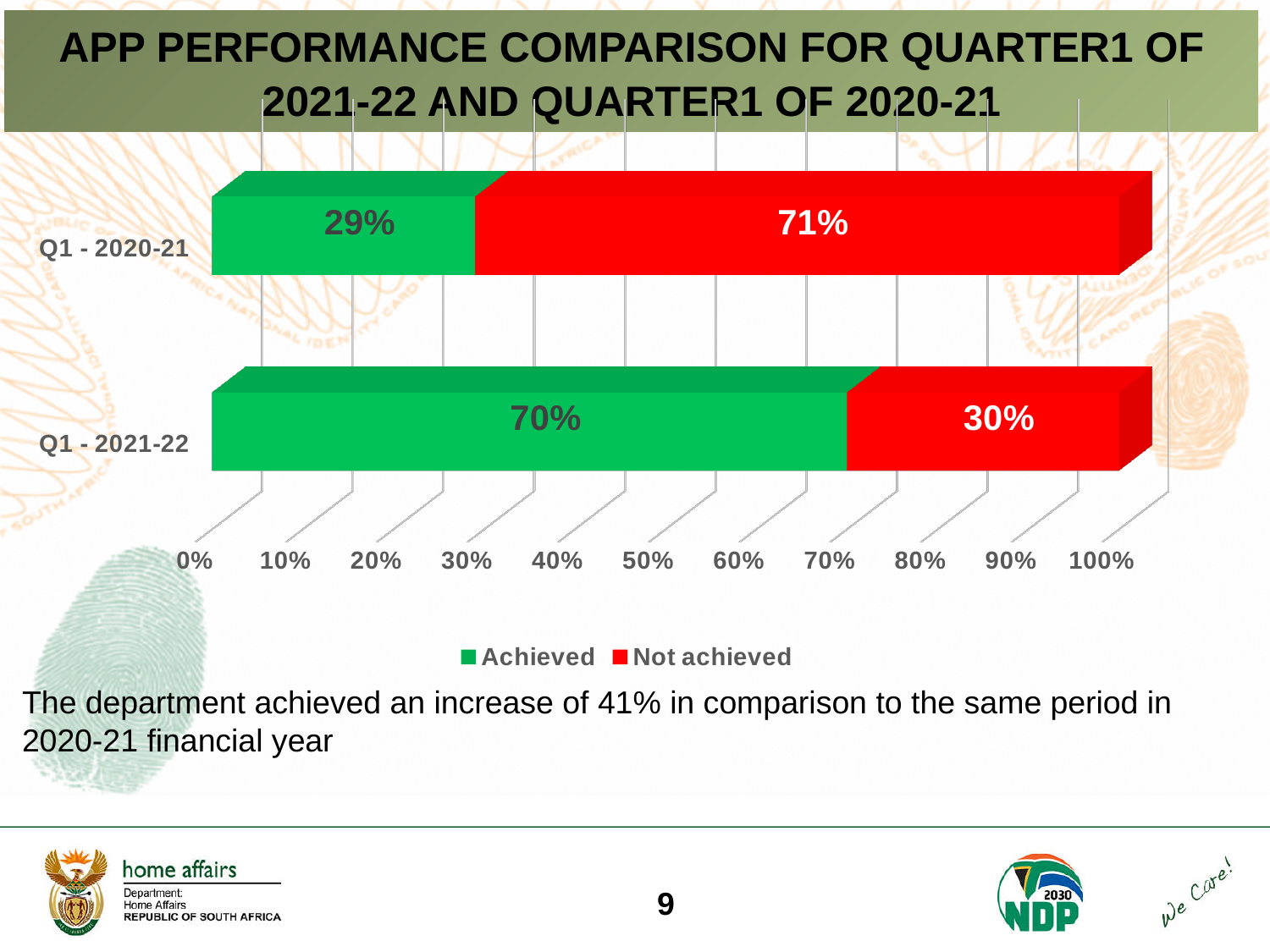
What colour represents the Not achieved series? Red What percentage was Not achieved in Q1 - 2021-22? 30% Which quarter has the higher Achieved percentage? Q1 - 2021-22 Is the Not achieved value for Q1 - 2020-21 larger or smaller than the Achieved value for Q1 - 2021-22? larger What kind of chart is shown on the slide? Stacked bar chart What percentage was Not achieved in Q1 - 2020-21? 71% What is the difference in the Achieved percentage between Q1 - 2021-22 and Q1 - 2020-21? 41% Which quarter has the lower Not achieved percentage? Q1 - 2021-22 What percentage was Achieved in Q1 - 2021-22? 70% How many series does the legend list? 2 How many categories (quarters) are shown on the chart? 2 What percentage was Achieved in Q1 - 2020-21? 29%